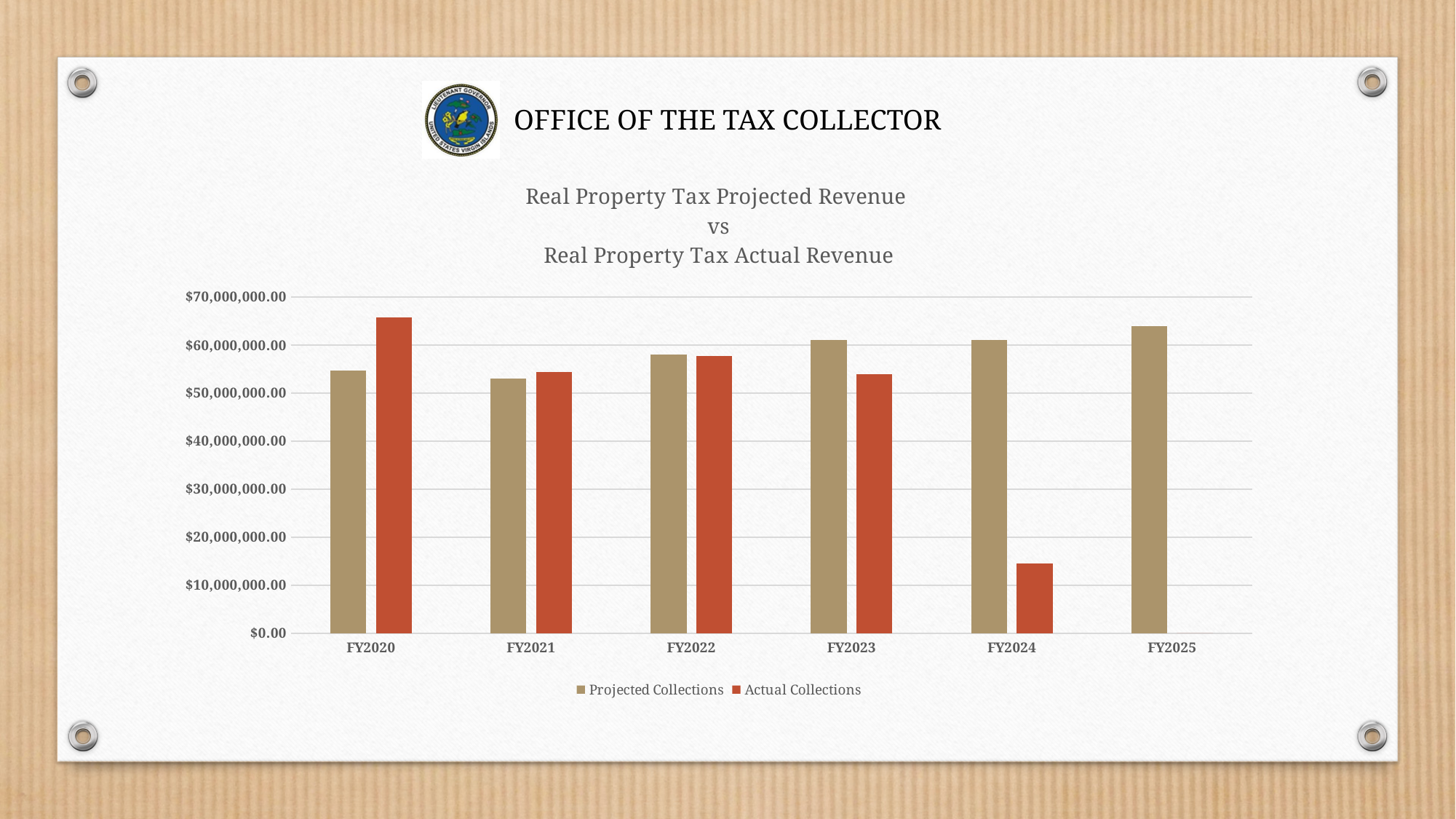
Which fiscal year has the highest Projected Collections? FY2025 In FY2023, which is larger: Projected Collections or Actual Collections? Projected Collections What kind of chart is shown on the slide? Bar chart In FY2020, which is larger: Projected Collections or Actual Collections? Actual Collections Which fiscal year has the lowest Actual Collections bar shown? FY2024 How many fiscal years are shown on the x axis of the chart? 6 Is the Actual Collections value for FY2020 greater or less than $60,000,000.00? greater Is the Actual Collections value for FY2024 greater or less than $20,000,000.00? less Which fiscal year has no Actual Collections bar shown? FY2025 How many series does the chart's legend list? 2 Which fiscal year has the highest Actual Collections? FY2020